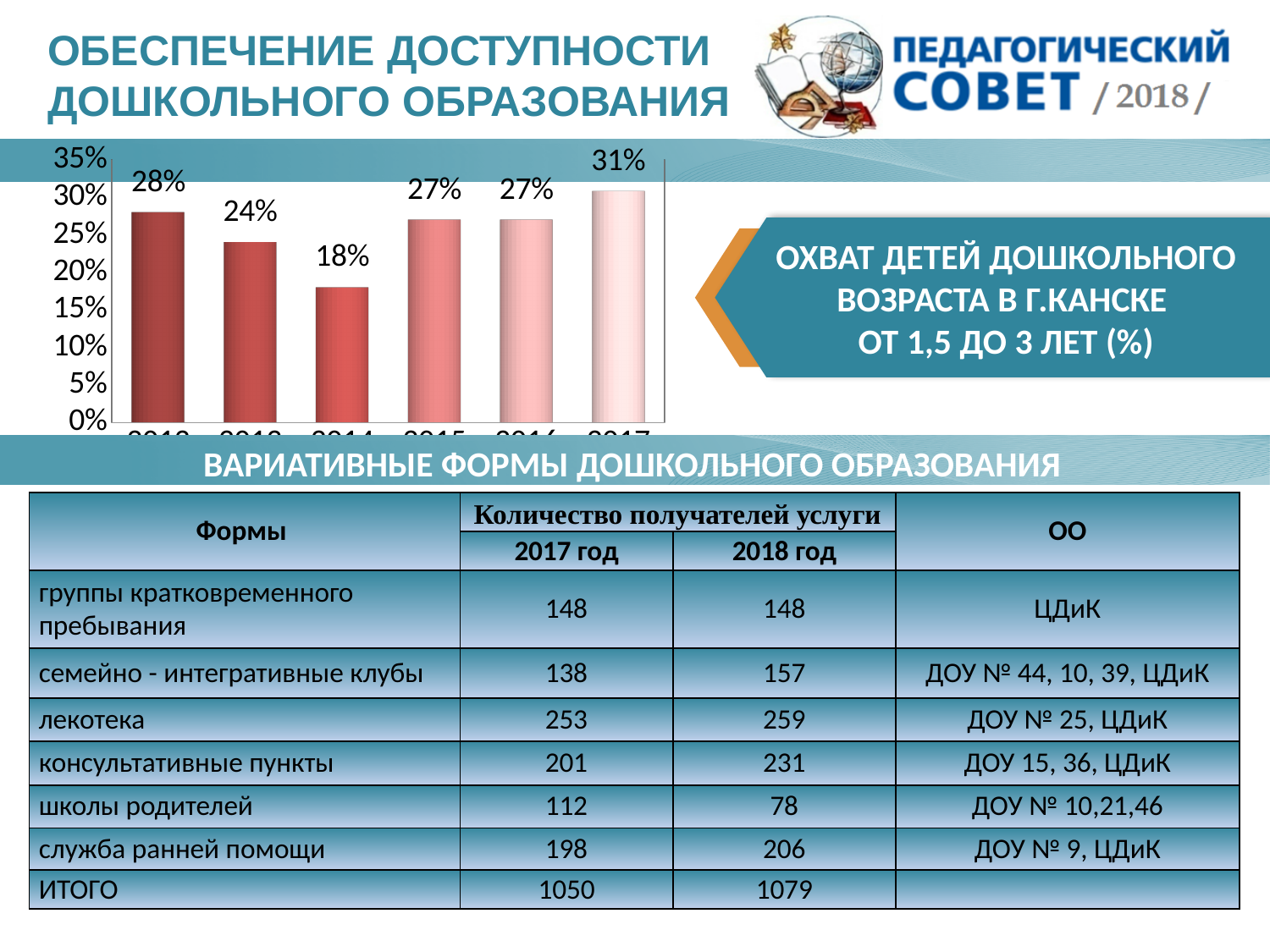
Is the value of the last (rightmost) bar greater or less than 30%? greater Do the values rise or fall from the third bar to the last bar? rise What is the highest value shown in the chart? 31% What is the lowest value shown in the chart? 18% What is the value shown on the first (leftmost) bar of the chart? 28% What is the value shown on the third bar of the chart? 18% What is the maximum value shown on the chart's vertical axis? 35% What is the value shown on the second bar of the chart? 24% Which is larger, the value of the first bar or the value of the second bar? the first bar (28%) What type of chart is shown on the slide? bar chart How many bars are plotted in the chart? 6 What is the difference between the highest and lowest values in the chart? 13 percentage points